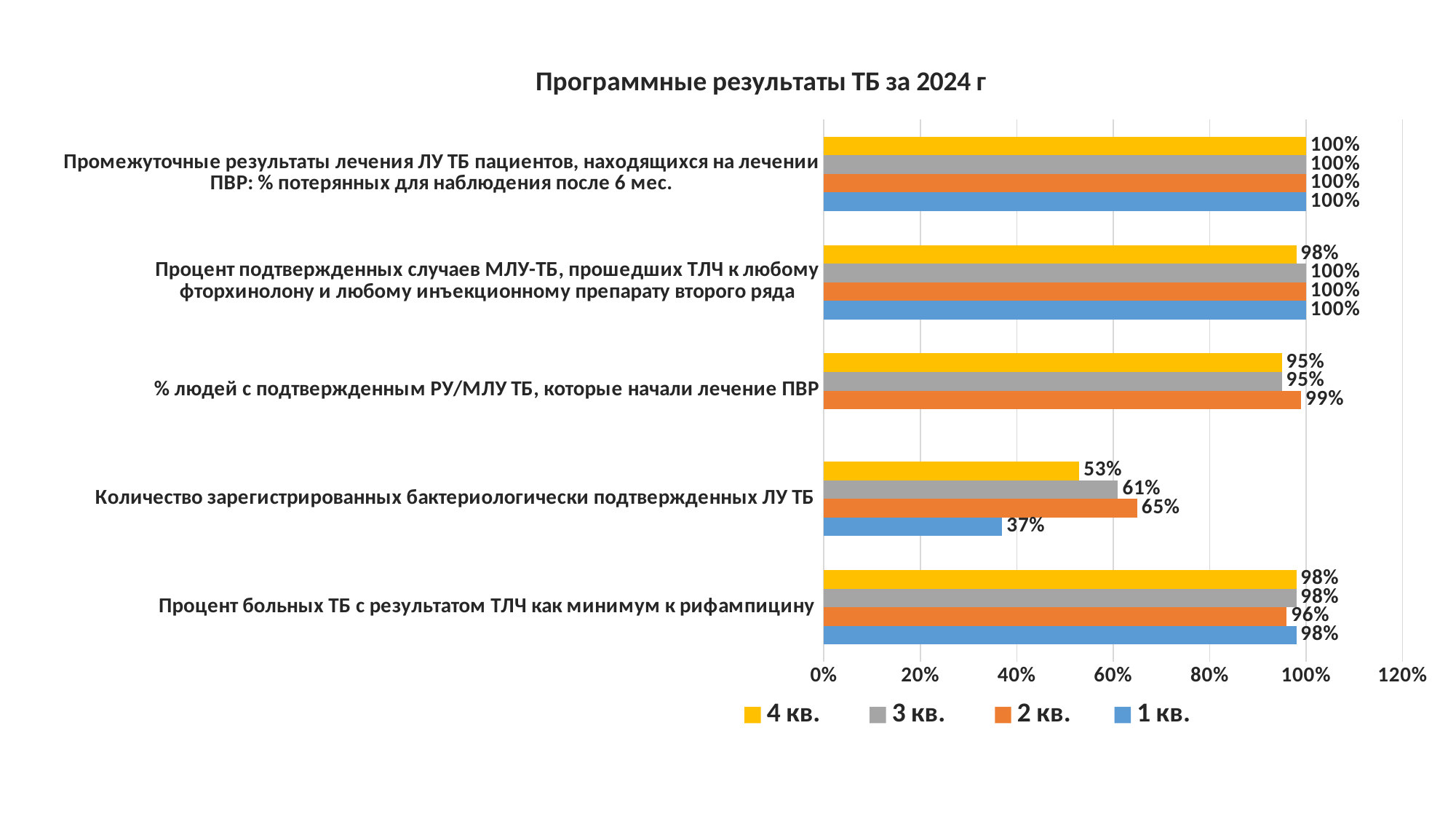
Which quarter has the lowest value in the category "Процент больных ТБ с результатом ТЛЧ как минимум к рифампицину"? 2 кв. What is the difference between the 2 кв. and 1 кв. values in the category "Количество зарегистрированных бактериологически подтвержденных ЛУ ТБ"? 28% What is the title of the chart? Программные результаты ТБ за 2024 г In the category "Количество зарегистрированных бактериологически подтвержденных ЛУ ТБ", which is larger: the value for 3 кв. or the value for 4 кв.? 3 кв. What is the value for 1 кв. in the category "Количество зарегистрированных бактериологически подтвержденных ЛУ ТБ"? 37% How many series does the legend list? 4 What is the value for 4 кв. in the category "Процент подтвержденных случаев МЛУ-ТБ, прошедших ТЛЧ к любому фторхинолону и любому инъекционному препарату второго ряда"? 98% What kind of chart is shown on the slide? bar chart How many categories are shown on the chart? 5 Which quarter has the highest value in the category "Количество зарегистрированных бактериологически подтвержденных ЛУ ТБ"? 2 кв. Which series is shown in blue in the legend? 1 кв. What is the value for 2 кв. in the category "% людей с подтвержденным РУ/МЛУ ТБ, которые начали лечение ПВР"? 99%